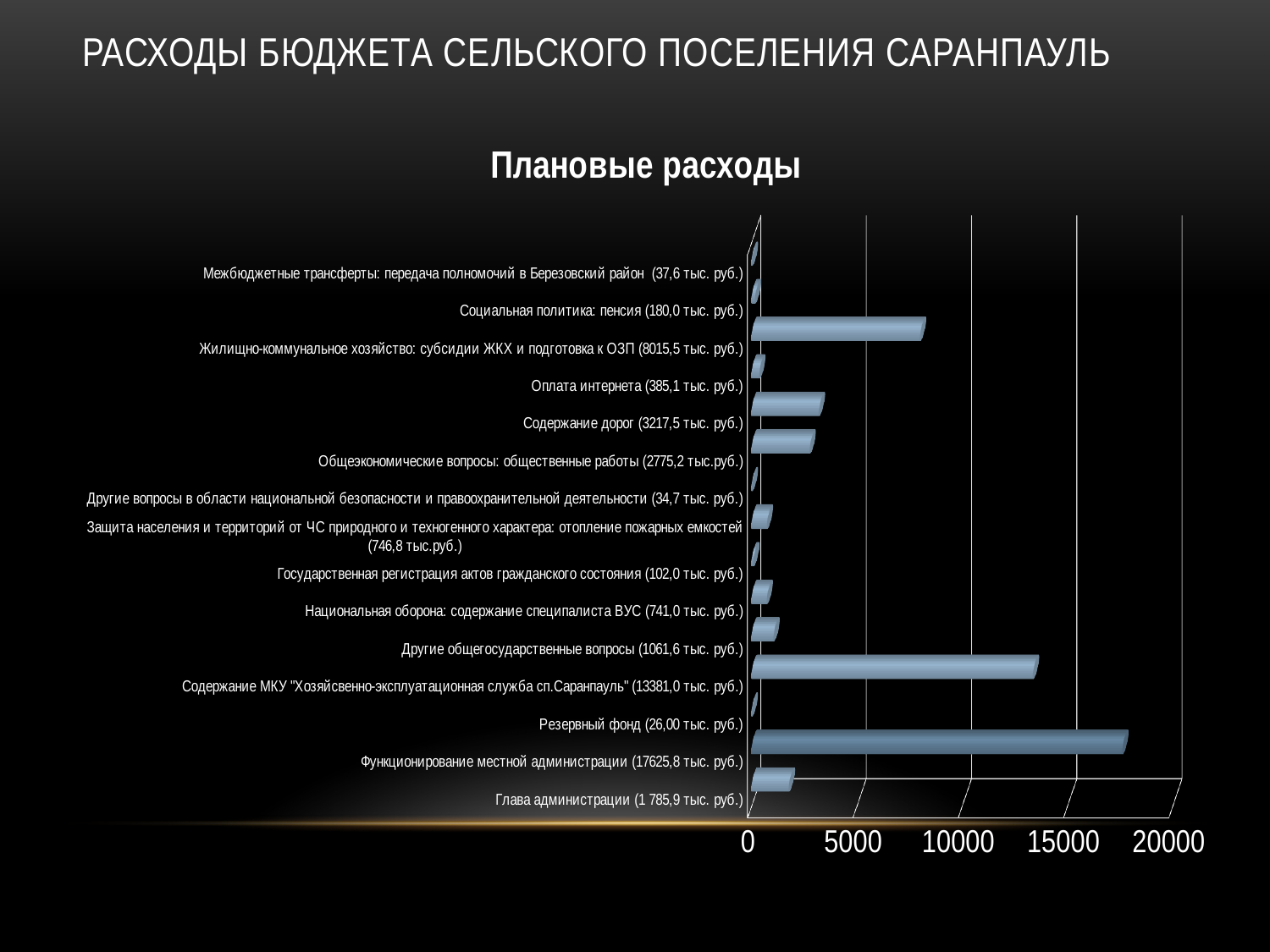
What is the title of the chart? Плановые расходы Which category has the lowest value in the chart? Резервный фонд Which is larger: Содержание дорог or Общеэкономические вопросы: общественные работы? Содержание дорог What is the difference between Функционирование местной администрации and Содержание МКУ "Хозяйсвенно-эксплуатационная служба сп.Саранпауль"? 4244,8 тыс. руб. Is the value for Содержание МКУ "Хозяйсвенно-эксплуатационная служба сп.Саранпауль" greater or less than 15000? less What kind of chart is shown on the slide? Bar chart What is the value for Жилищно-коммунальное хозяйство: субсидии ЖКХ и подготовка к ОЗП? 8015,5 тыс. руб. Which category has the highest value in the chart? Функционирование местной администрации What is the maximum value shown on the horizontal axis? 20000 How many categories are plotted in the chart? 15 What is the value for Содержание дорог? 3217,5 тыс. руб. What is the value for Функционирование местной администрации? 17625,8 тыс. руб.